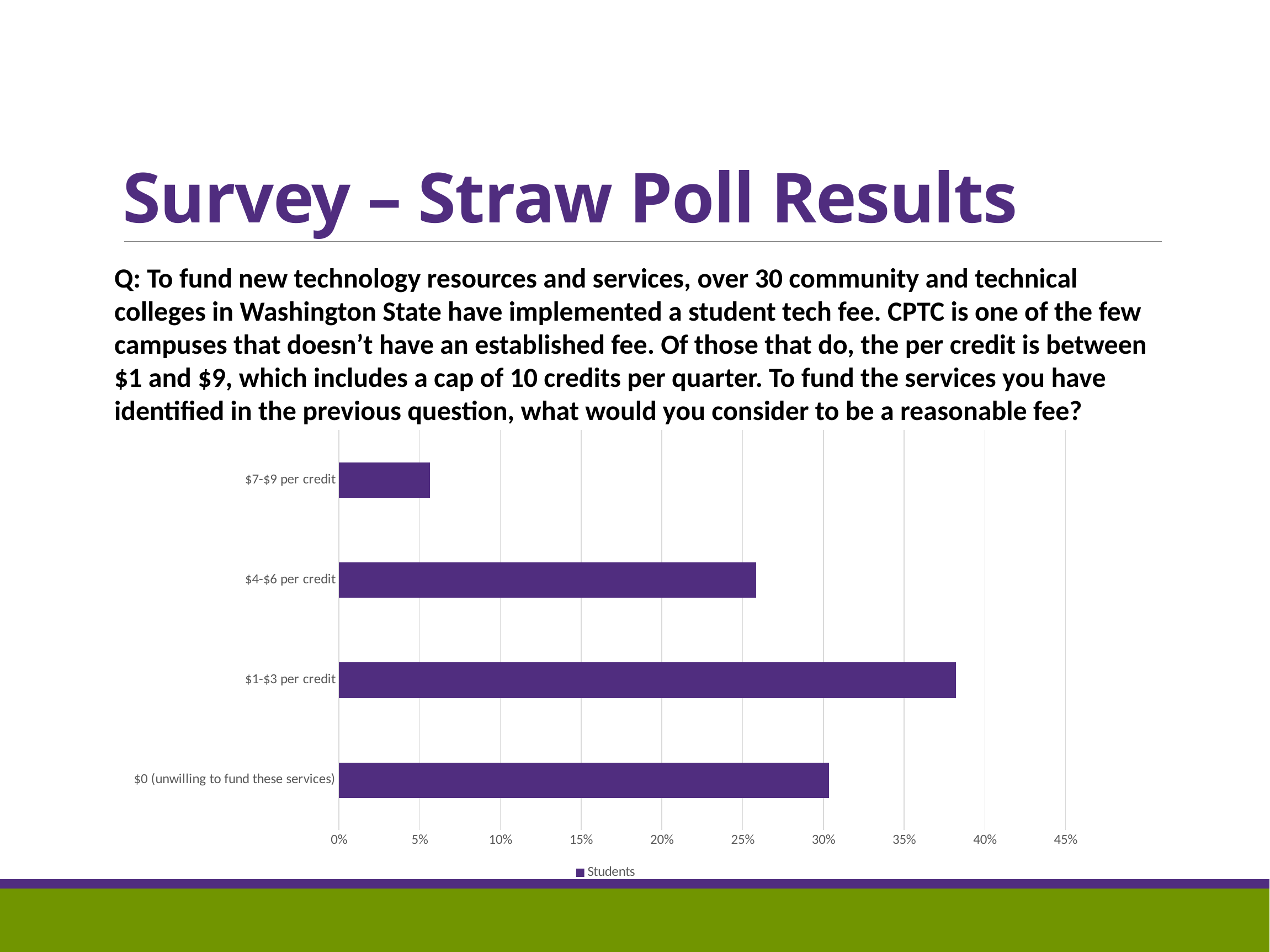
Which has a larger share of students: $1-$3 per credit or $0 (unwilling to fund these services)? $1-$3 per credit Is the value for $4-$6 per credit greater or less than 20%? greater What kind of chart is shown on the slide? bar chart Which fee category has the highest share of students? $1-$3 per credit Which has a larger share of students: $0 (unwilling to fund these services) or $4-$6 per credit? $0 (unwilling to fund these services) Is the value for $1-$3 per credit greater or less than 35%? greater Which fee category has the lowest share of students? $7-$9 per credit Is the value for $0 (unwilling to fund these services) greater or less than 25%? greater How many fee categories are plotted in the chart? 4 What is the name of the series shown in the chart legend? Students How many series does the chart legend list? 1